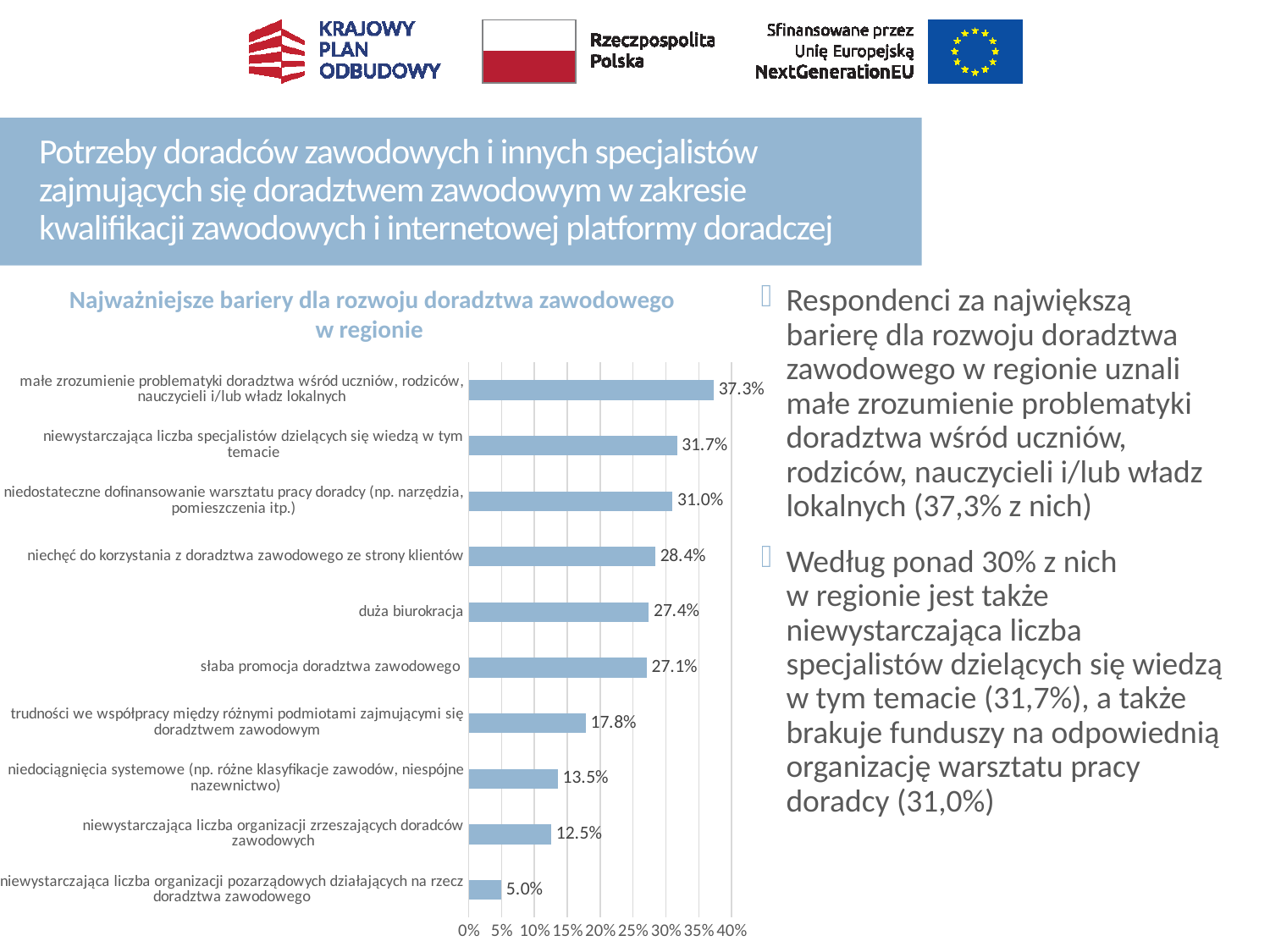
What is the value for 'duża biurokracja'? 27.4% What kind of chart is shown on the slide? bar chart Which category has the lowest value? niewystarczająca liczba organizacji pozarządowych działających na rzecz doradztwa zawodowego What is the value for 'niechęć do korzystania z doradztwa zawodowego ze strony klientów'? 28.4% Which is larger: the value for 'trudności we współpracy między różnymi podmiotami zajmującymi się doradztwem zawodowym' or 'niedociągnięcia systemowe (np. różne klasyfikacje zawodów, niespójne nazewnictwo)'? trudności we współpracy między różnymi podmiotami zajmującymi się doradztwem zawodowym Is the value for 'słaba promocja doradztwa zawodowego' greater or less than 25%? greater What is the difference between the values for 'niewystarczająca liczba specjalistów dzielących się wiedzą w tym temacie' and 'niedostateczne dofinansowanie warsztatu pracy doradcy (np. narzędzia, pomieszczenia itp.)'? 0.7% What is the difference between the highest and lowest values in the chart? 32.3% How many categories are shown in the chart? 10 Which category has the highest value? małe zrozumienie problematyki doradztwa wśród uczniów, rodziców, nauczycieli i/lub władz lokalnych What is the value for 'niewystarczająca liczba organizacji zrzeszających doradców zawodowych'? 12.5% What is the title of the chart? Najważniejsze bariery dla rozwoju doradztwa zawodowego w regionie